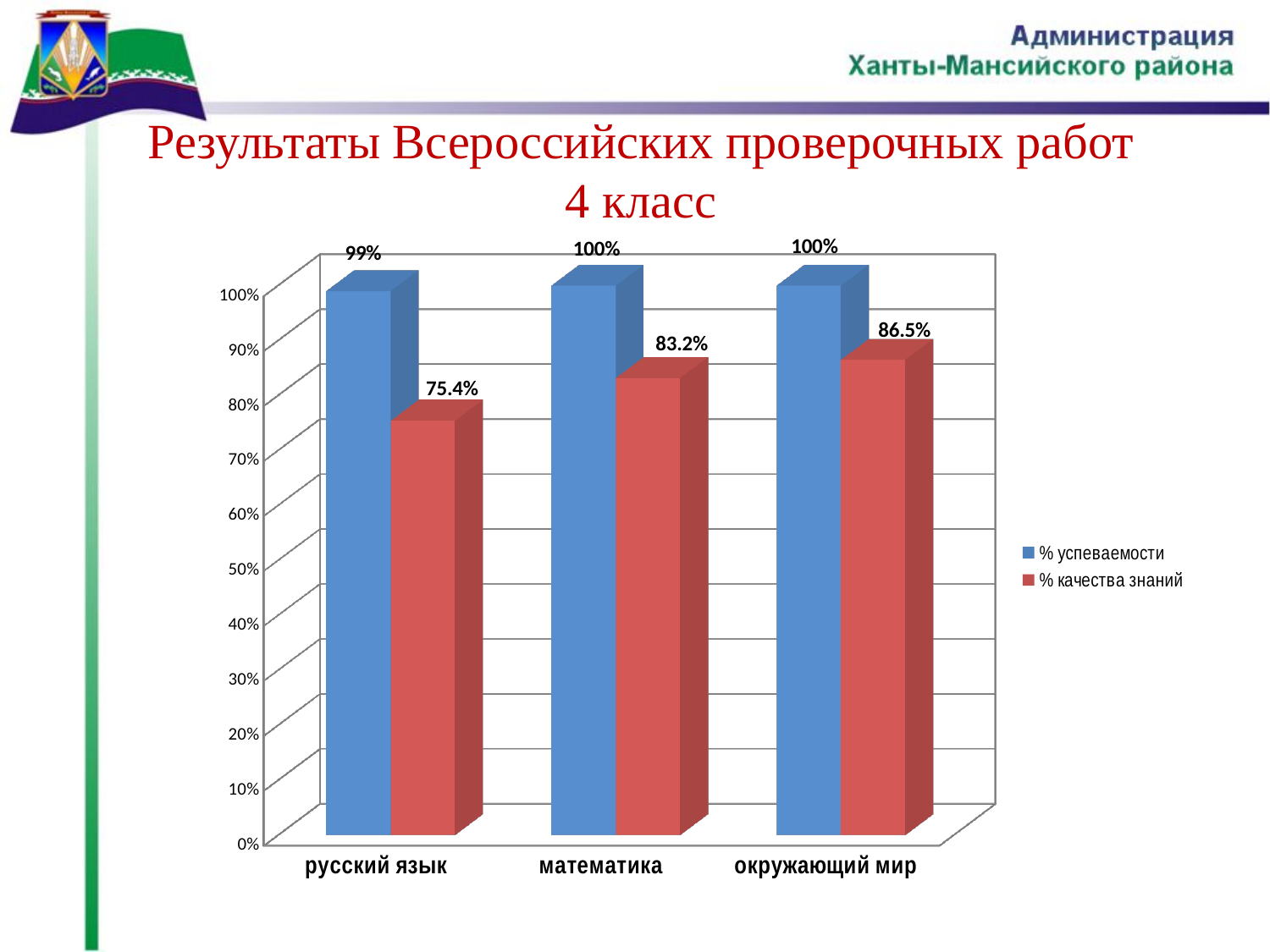
How many series does the legend list? 2 What kind of chart is shown on the slide? bar chart What is the % качества знаний value for математика? 83.2% Which subject has the lowest % качества знаний? русский язык What is the % успеваемости value for русский язык? 99% Which colour represents % успеваемости in the chart? blue What is the difference between % успеваемости and % качества знаний for русский язык? 23.6% Which subject has the highest % качества знаний? окружающий мир Which is larger: % качества знаний for математика or for русский язык? математика How many subjects are shown on the x axis? 3 What is the % качества знаний value for окружающий мир? 86.5% What is the difference in % качества знаний between окружающий мир and математика? 3.3%